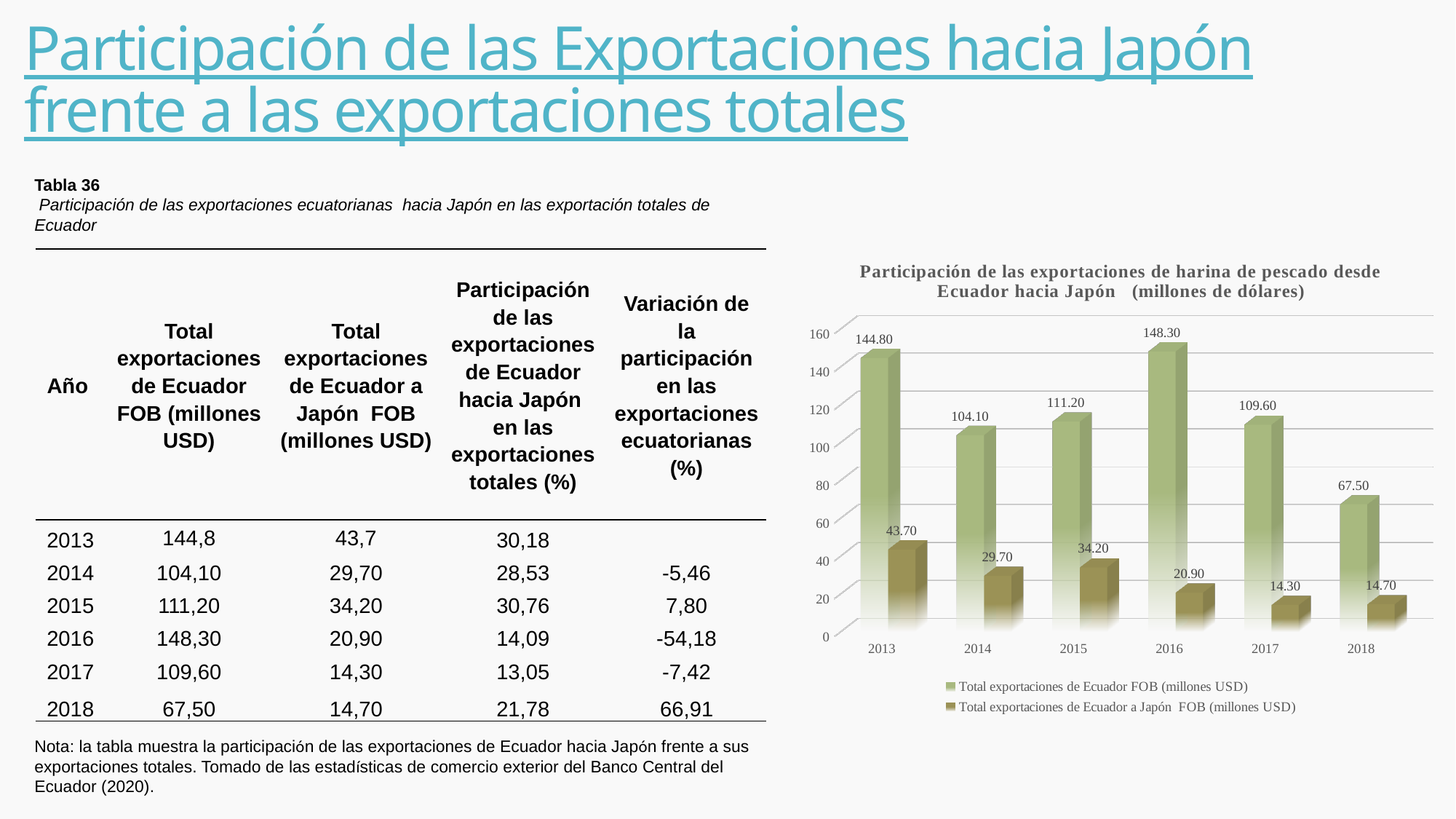
How many years are shown on the x axis of the chart? 6 Which year has the lowest value for Total exportaciones de Ecuador a Japón FOB (millones USD)? 2017 What is the value of Total exportaciones de Ecuador FOB (millones USD) for 2016? 148.30 What kind of chart is shown on the slide? bar chart Is the value for Total exportaciones de Ecuador FOB in 2018 greater or less than 80? less Which year has the highest value for Total exportaciones de Ecuador FOB (millones USD)? 2016 What is the difference between Total exportaciones de Ecuador FOB and Total exportaciones de Ecuador a Japón FOB in 2013? 101.10 Does the value for Total exportaciones de Ecuador a Japón FOB rise or fall from 2015 to 2017? fall How many series does the chart legend list? 2 What is the title of the chart? Participación de las exportaciones de harina de pescado desde Ecuador hacia Japón (millones de dólares) Which is larger: Total exportaciones de Ecuador FOB in 2014 or in 2015? 2015 What is the value of Total exportaciones de Ecuador a Japón FOB (millones USD) for 2014? 29.70